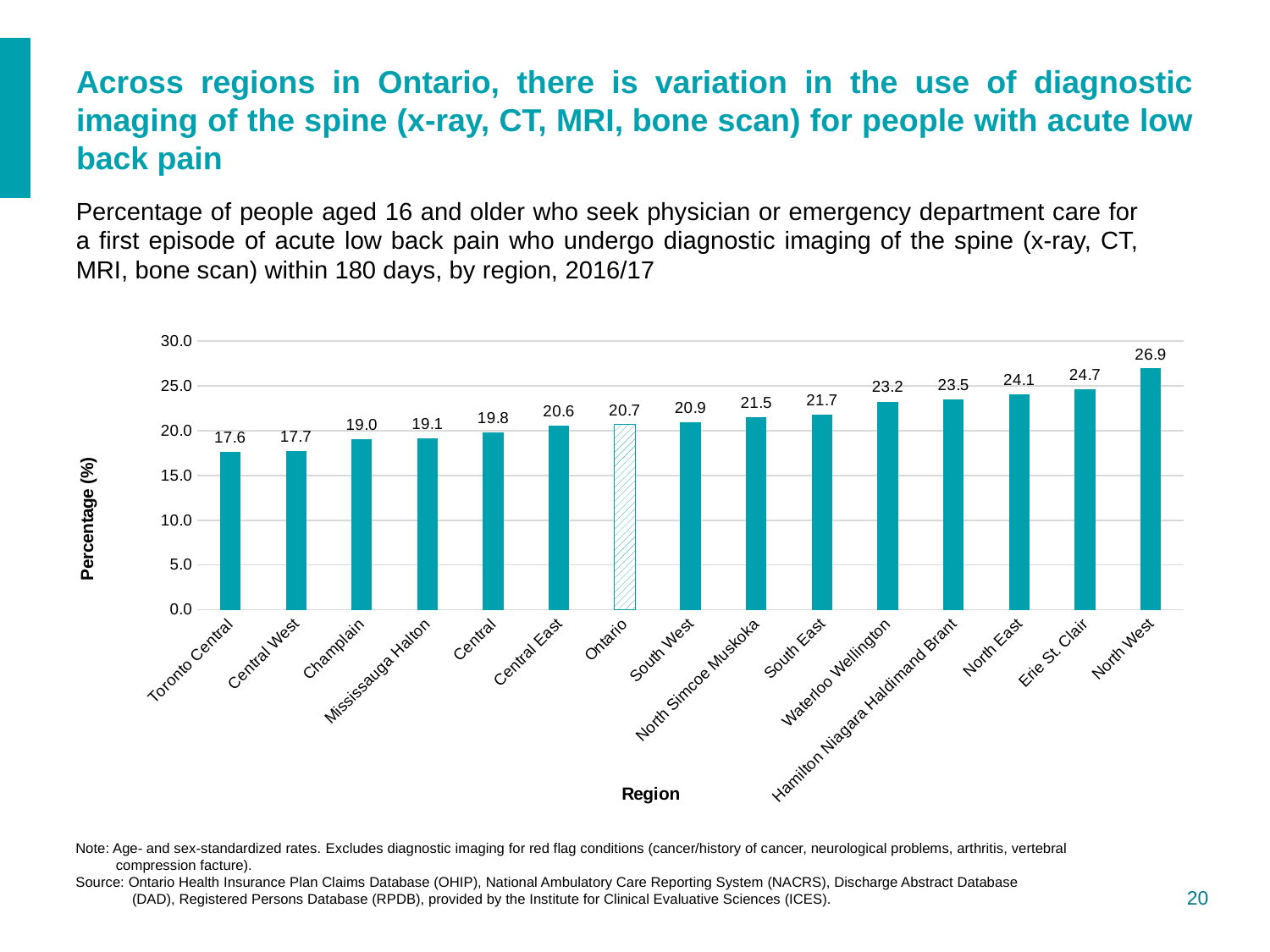
Which region has the highest value? North West What is the difference between the values for North West and Toronto Central? 9.3 What is the label of the y axis? Percentage (%) Which region has the lowest value? Toronto Central What is the value for Ontario? 20.7 How many bars are shown in the chart? 15 Is the value for Erie St. Clair greater or less than 20.0? greater What kind of chart is shown on the slide? bar chart Do the values rise or fall from left to right along the x axis? rise What is the value for North West? 26.9 Which has a larger value, Waterloo Wellington or Central East? Waterloo Wellington What is the value for Mississauga Halton? 19.1